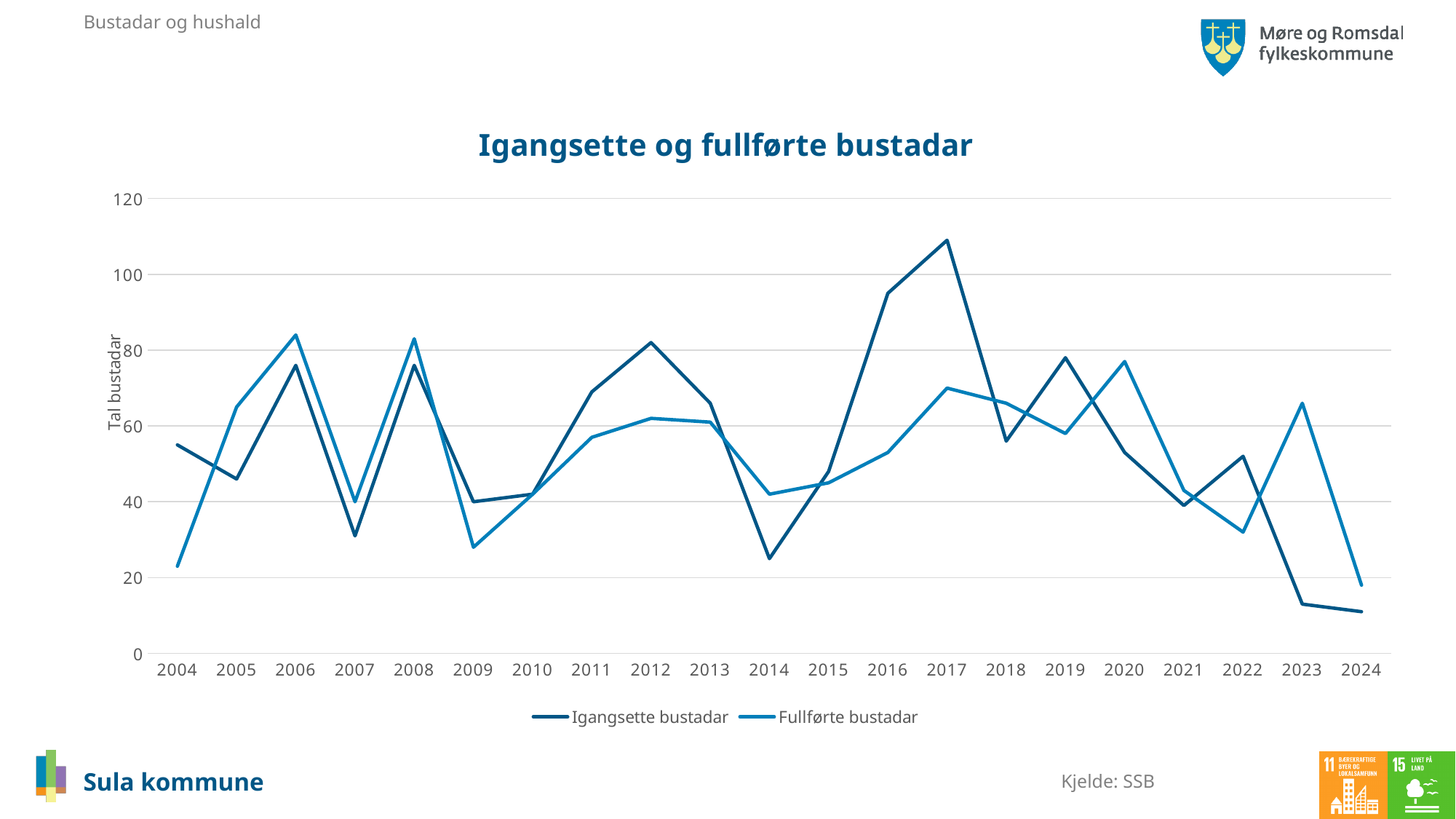
Does the value for Igangsette bustadar rise or fall from 2022 to 2024? fall What is the title of the y axis? Tal bustadar How many years are shown on the x axis? 21 How many series does the legend list? 2 In which year is the value for Igangsette bustadar highest? 2017 In which year is the value for Fullførte bustadar lowest? 2024 Is the value for Igangsette bustadar in 2017 greater or less than 100? greater What kind of chart is shown on the slide? line chart Is the value for Fullførte bustadar in 2004 greater or less than 40? less In 2023, which series has the larger value, Igangsette bustadar or Fullførte bustadar? Fullførte bustadar Is the value for Igangsette bustadar in 2014 greater or less than 40? less In 2016, which series has the larger value, Igangsette bustadar or Fullførte bustadar? Igangsette bustadar